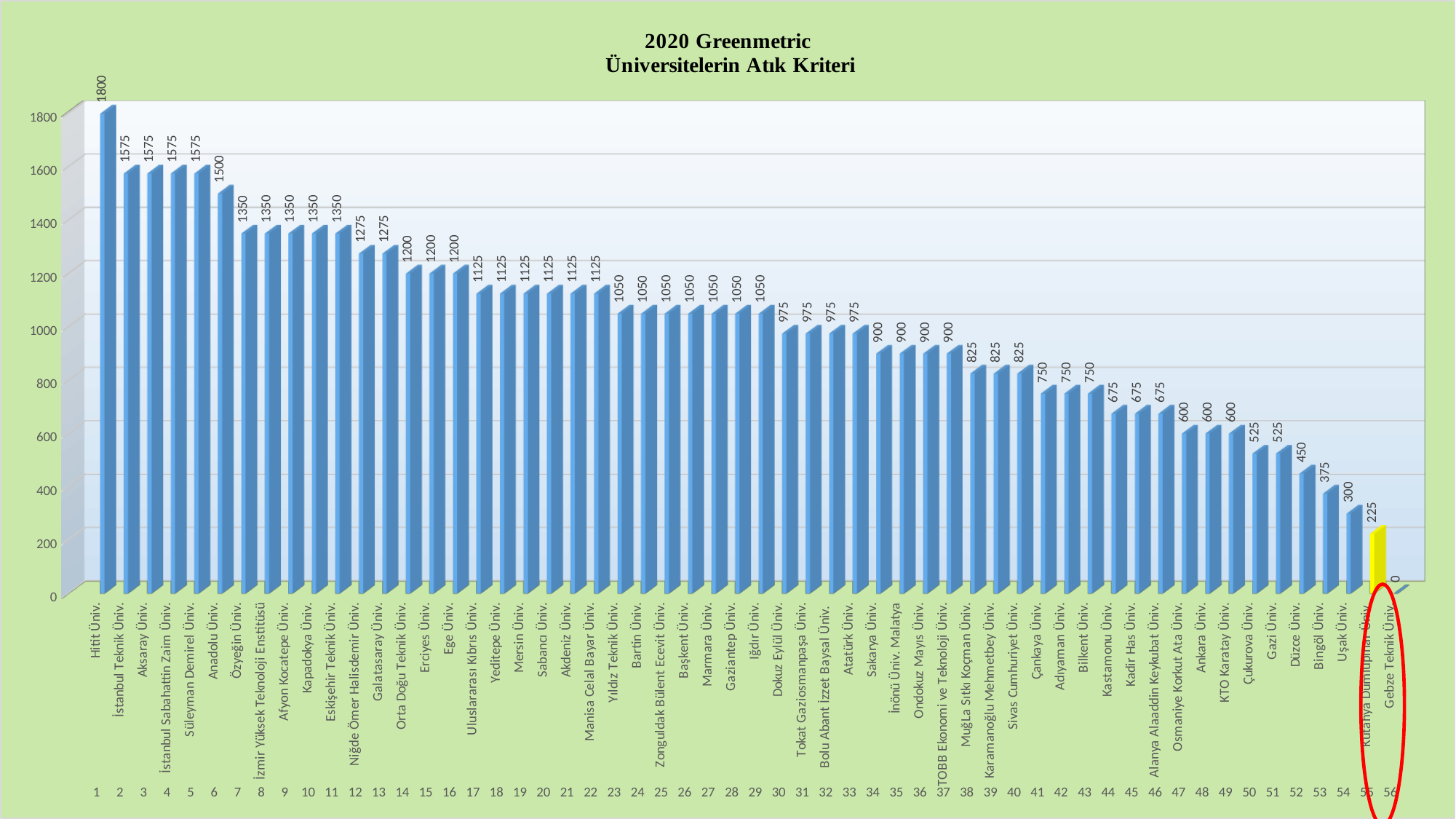
What kind of chart is this? Bar chart What is the title of the chart? 2020 Greenmetric Üniversitelerin Atık Kriteri Which university has the lowest value? Gebze Teknik Üniv. What is the value for Kütahya Dumlupınar Üniv.? 225 What is the value for Hitit Üniv.? 1800 What is the value for Düzce Üniv.? 450 What is the value for Anadolu Üniv.? 1500 Which university has the highest value? Hitit Üniv. What is the difference between the values for Hitit Üniv. and İstanbul Teknik Üniv.? 225 How many universities are shown in the chart? 56 Do the values rise or fall from left to right along the x axis? Fall Which is larger, the value for Galatasaray Üniv. or the value for Ege Üniv.? Galatasaray Üniv.